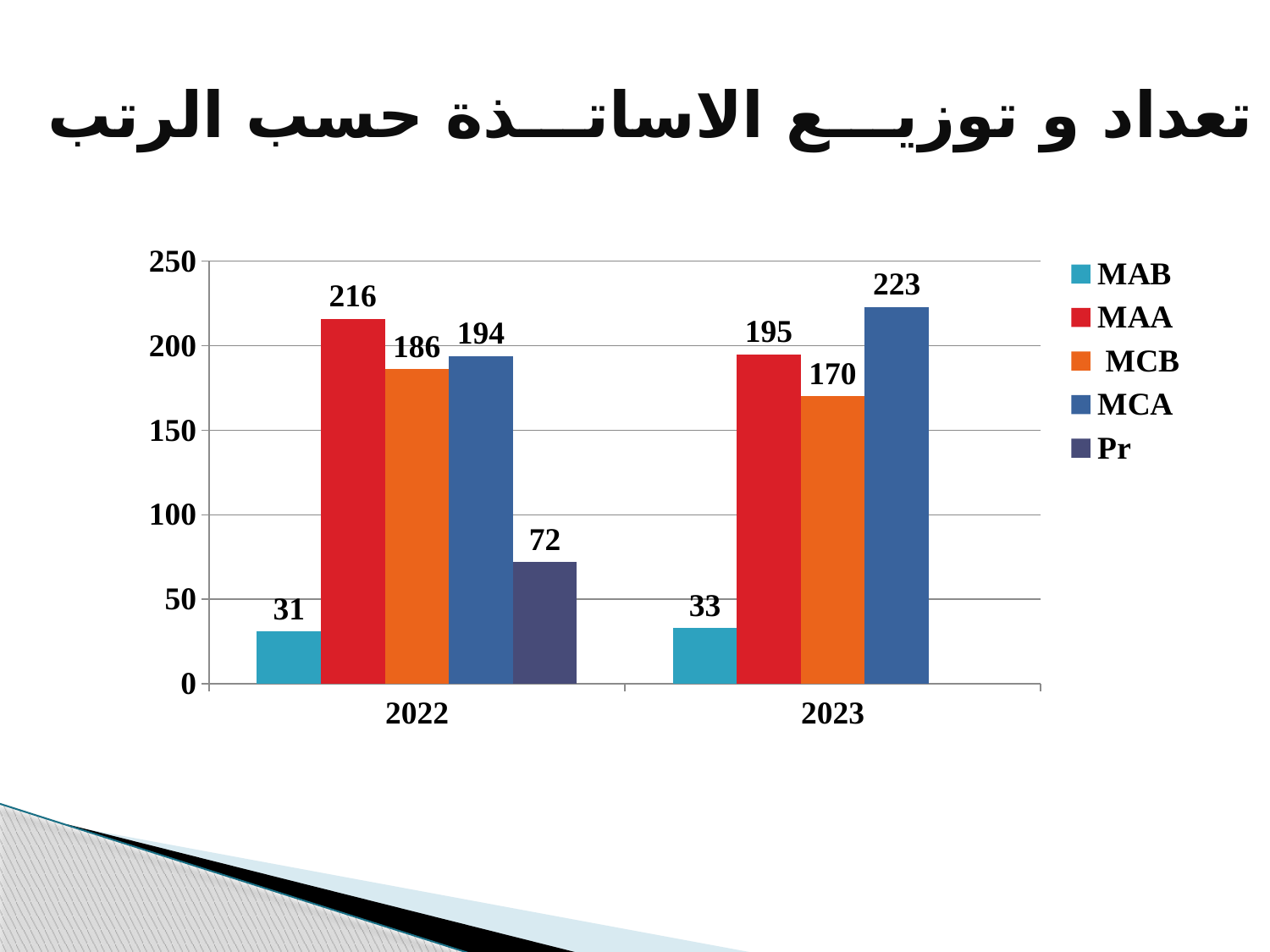
Which series has the lowest value in 2022? MAB What is the value for MCA in 2023? 223 What kind of chart is shown on the slide? Bar chart What is the difference between the MAA values for 2022 and 2023? 21 What is the value for MCB in 2023? 170 Which series has the highest value in 2023? MCA Does the MAB value rise or fall from 2022 to 2023? Rise How many series does the legend list? 5 What is the value for MAA in 2022? 216 What is the value for Pr in 2022? 72 Which is larger, the MCB value in 2022 or the MCA value in 2022? MCA in 2022 How many year categories are shown on the x axis? 2